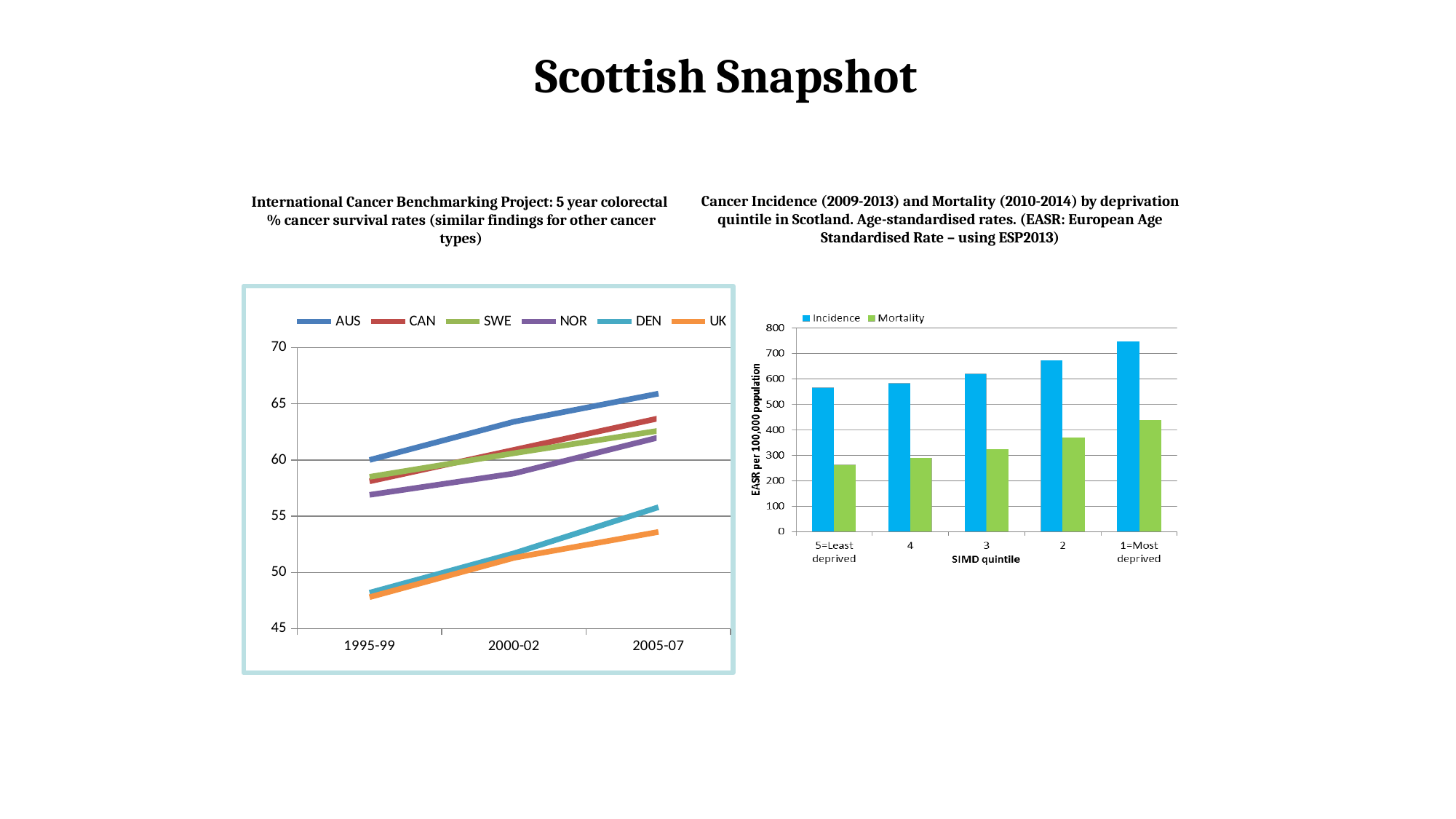
In the left chart, which country has the highest 5 year colorectal cancer survival rate in 2005-07? AUS In the right chart, which SIMD quintile has the highest incidence rate? 1=Most deprived In the left chart, is the survival rate for AUS in 2005-07 greater or less than 65? greater In the left chart, does the survival rate for DEN rise or fall from 1995-99 to 2005-07? rise In the right chart, is the mortality rate for 1=Most deprived greater or less than 400? greater In the right chart, which series is shown in green? Mortality In the left chart, how many countries does the legend list? 6 In the left chart, which country has the lowest survival rate in 2005-07? UK What kind of chart is the right chart (Cancer Incidence and Mortality by deprivation quintile)? bar chart In the right chart, how many SIMD quintile categories are shown on the x axis? 5 What kind of chart is the left chart (International Cancer Benchmarking Project)? line chart In the left chart, is the survival rate for UK in 1995-99 greater or less than 50? less